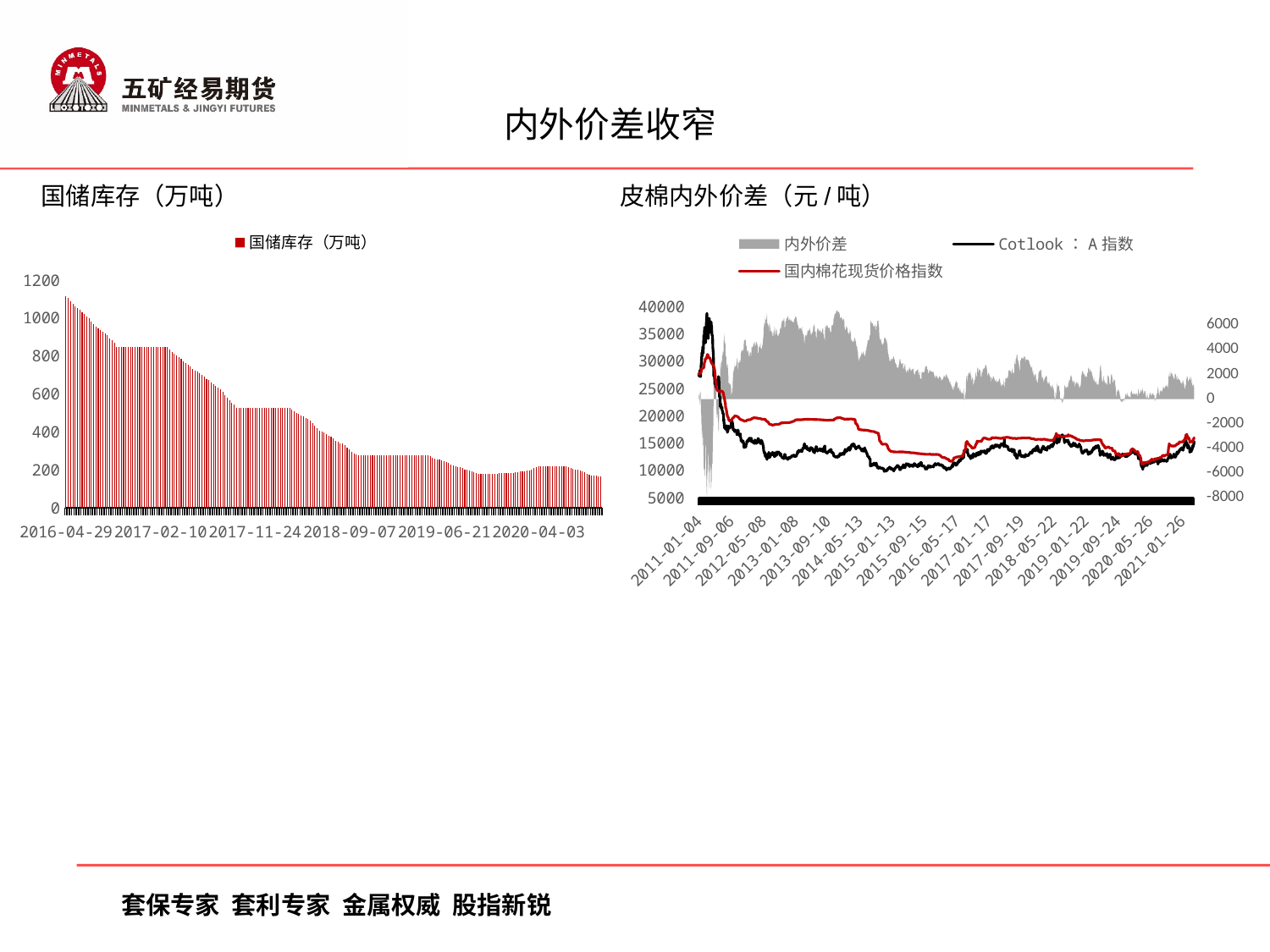
What is the first date label on the x axis of the right chart 皮棉内外价差（元/吨）? 2011-01-04 In the right chart 皮棉内外价差（元/吨）, around 2014-05-13, which line is higher: 国内棉花现货价格指数 or Cotlook：A指数? 国内棉花现货价格指数 How many series does the legend of the left chart 国储库存（万吨） list? 1 In the right chart 皮棉内外价差（元/吨）, does the Cotlook：A指数 line overall rise or fall from its 2011 peak to 2021? fall How many series does the legend of the right chart 皮棉内外价差（元/吨） list? 3 What kind of chart is the left chart titled 国储库存（万吨）? bar chart In the right chart 皮棉内外价差（元/吨）, is the peak of the Cotlook：A指数 line in 2011 greater or less than 30000 on the left axis? greater In the left chart 国储库存（万吨）, is the value of the first bar at 2016-04-29 greater or less than 1000? greater In the right chart 皮棉内外价差（元/吨）, what colour is the Cotlook：A指数 line? black In the right chart 皮棉内外价差（元/吨）, which series is drawn as a gray shaded area? 内外价差 In the left chart 国储库存（万吨）, do the values generally rise or fall from left to right along the x axis? fall In the left chart 国储库存（万吨）, is the value of the last bar on the right greater or less than 400? less